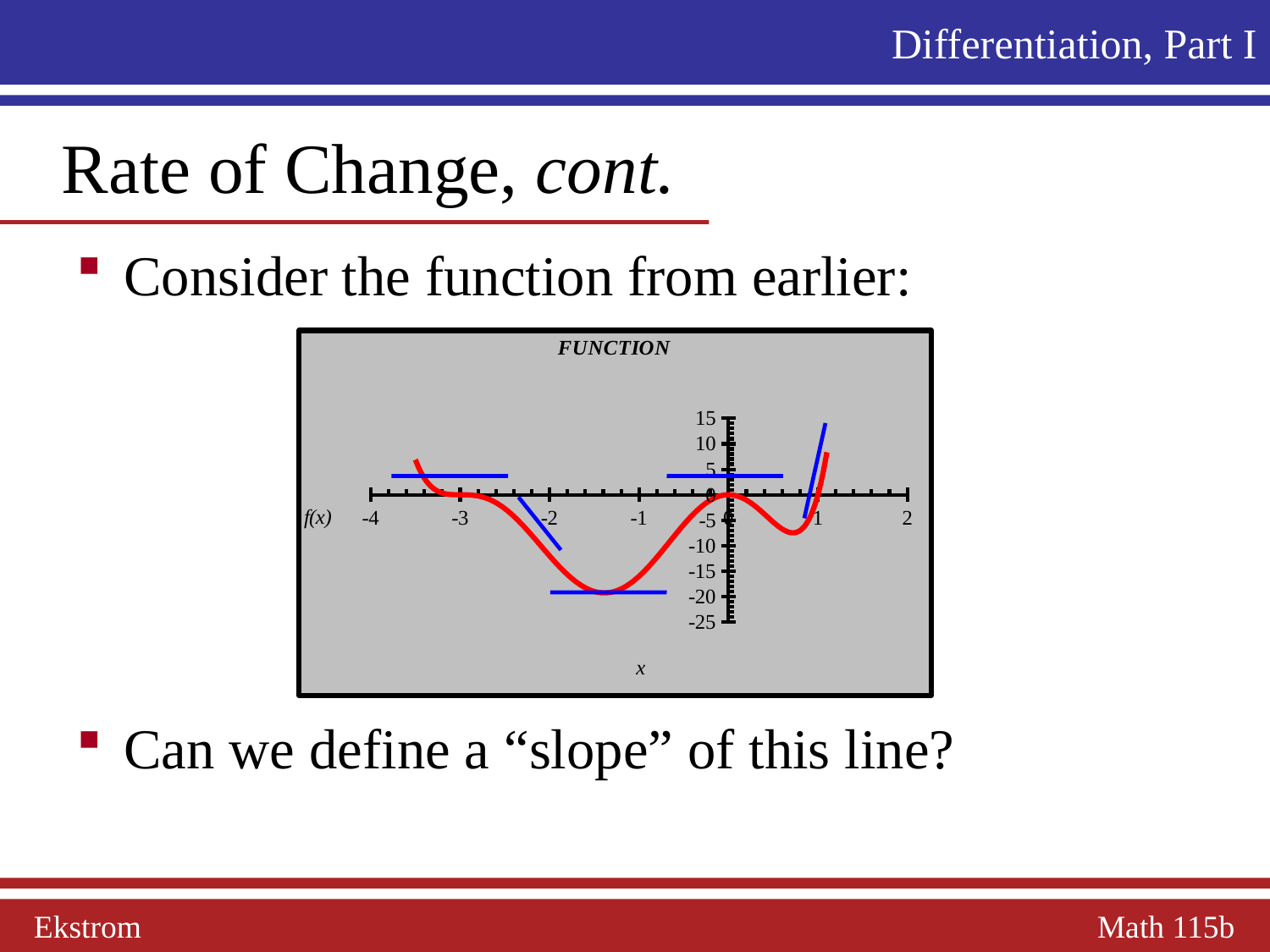
What is the title of the chart? FUNCTION Between x = -3 and x = -2, does the red curve rise or fall? fall What is the highest tick value shown on the vertical axis? 15 What label is shown on the horizontal axis of the chart? x Is the lowest value of the red curve greater or less than -25? greater Between x = -1 and x = 0, does the red curve rise or fall? rise Is the lowest value of the red curve greater or less than -15? less Is the value of the red curve at x = -3.5 greater or less than 0? greater What kind of chart is shown on the slide? line chart